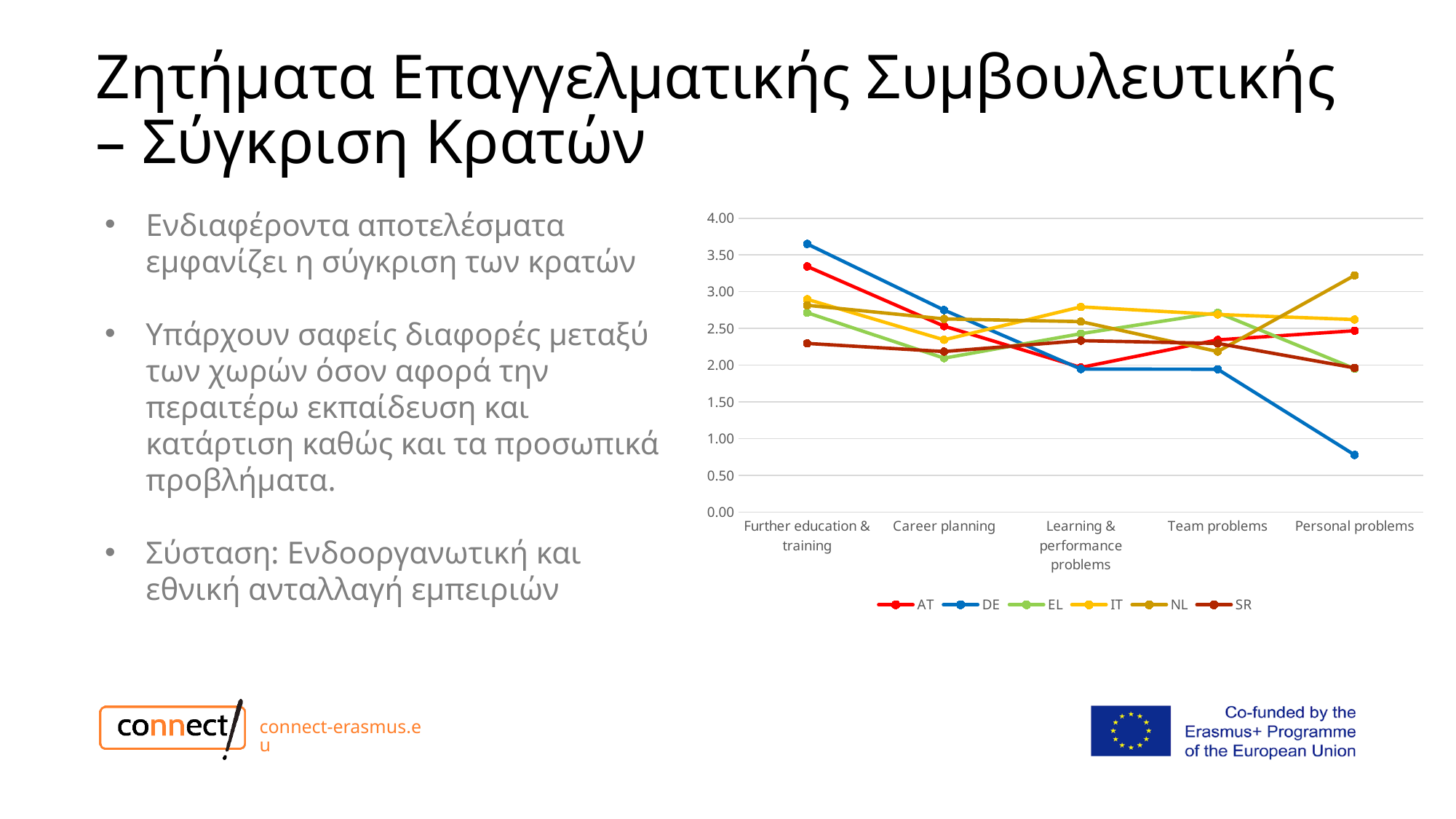
Which series has the lowest value for Personal problems? DE What colour is the DE line in the legend? blue Which series has the highest value for Further education & training? DE Does the DE series rise or fall overall from Further education & training to Personal problems? falls How many categories are shown on the x axis? 5 How many series does the legend list? 6 What kind of chart is shown on the slide? line chart Is the value for DE at Further education & training greater or less than 3.50? greater Is the value for DE at Personal problems greater or less than 1.00? less Which is larger at Further education & training, the value for AT or the value for SR? AT Is the value for NL at Personal problems greater or less than 3.00? greater Which series has the highest value for Personal problems? NL